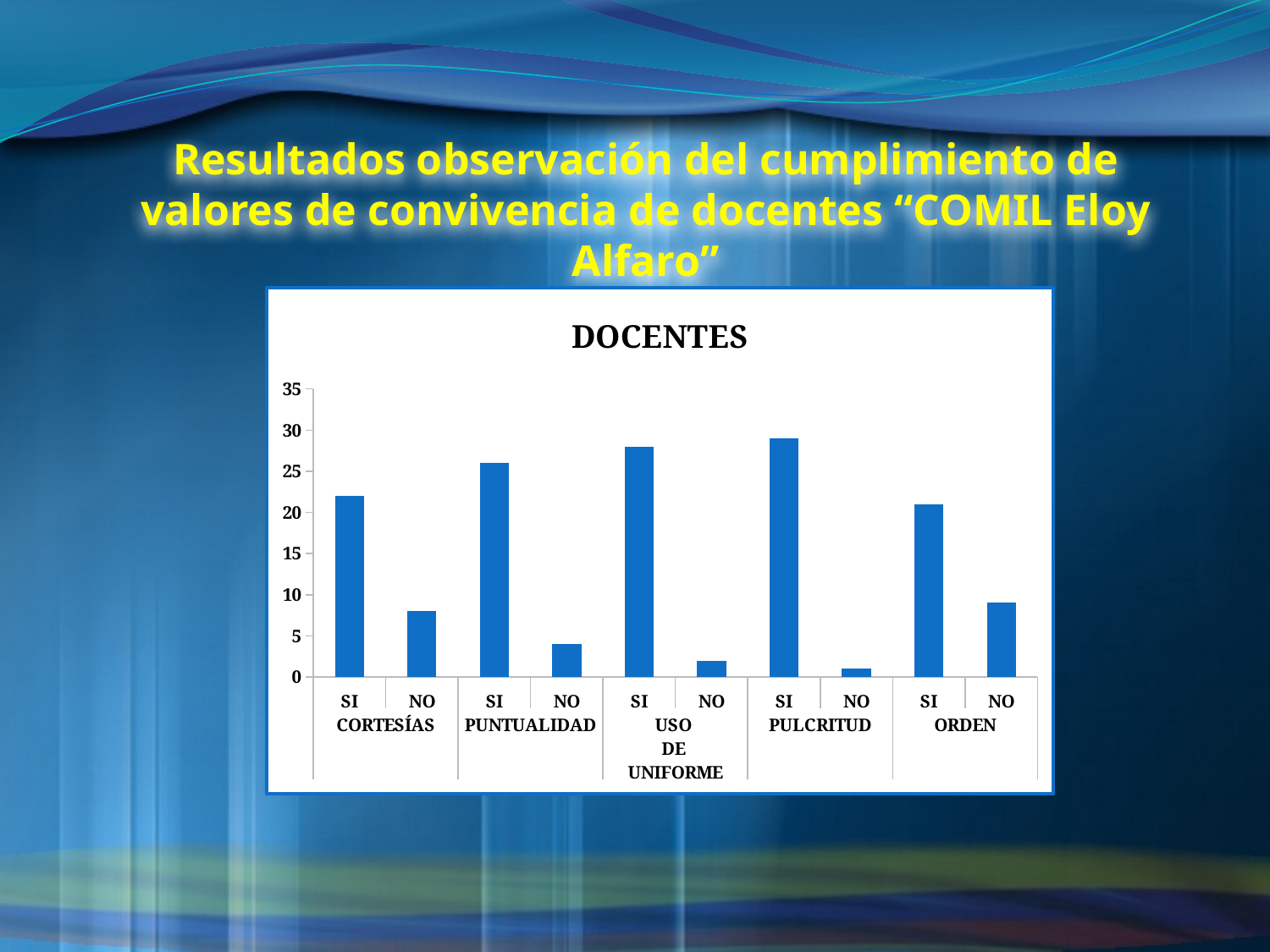
Is the value for SI under USO DE UNIFORME greater or less than 25? greater What kind of chart is shown on the slide? bar chart How many bars are plotted in the chart in total? 10 Is the value for SI under ORDEN greater or less than 25? less Which is larger, the NO bar for CORTESÍAS or the NO bar for USO DE UNIFORME? CORTESÍAS How many value categories (groups) are shown along the x axis of the chart? 5 Which is larger, the SI bar for PUNTUALIDAD or the SI bar for ORDEN? PUNTUALIDAD Is the value for NO under PUNTUALIDAD greater or less than 5? less What is the title of the chart? DOCENTES Which is larger for CORTESÍAS, the SI bar or the NO bar? SI